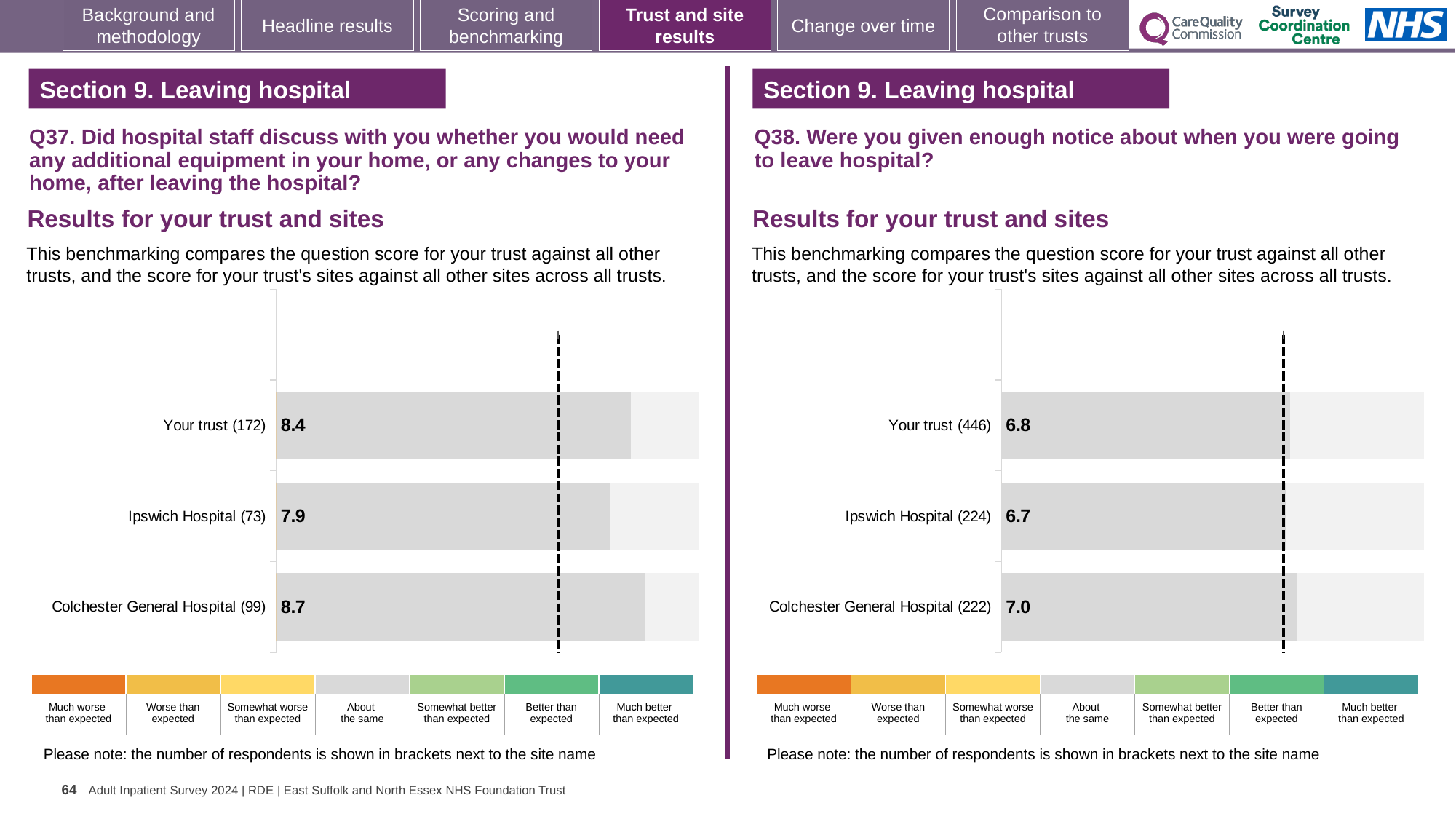
In the Q37 chart on the left, which site or trust has the lowest score? Ipswich Hospital (73) In the Q37 chart on the left, what is the difference between the scores for Colchester General Hospital (99) and Ipswich Hospital (73)? 0.8 In the Q37 chart on the left, what is the score for Ipswich Hospital (73)? 7.9 How many bars are plotted in the Q37 chart on the left? 3 In the Q38 chart on the right, what is the difference between the scores for Colchester General Hospital (222) and Your trust (446)? 0.2 In the Q38 chart on the right, which is larger: the score for Your trust (446) or Ipswich Hospital (224)? Your trust (446) In the Q37 chart on the left, what is the score for Your trust (172)? 8.4 In the Q38 chart on the right, which site or trust has the lowest score? Ipswich Hospital (224) In the Q38 chart on the right, what is the score for Colchester General Hospital (222)? 7.0 In the Q37 chart on the left, which site or trust has the highest score? Colchester General Hospital (99) In the Q38 chart on the right, what is the score for Your trust (446)? 6.8 What kind of chart is used in the Q38 chart on the right? Bar chart